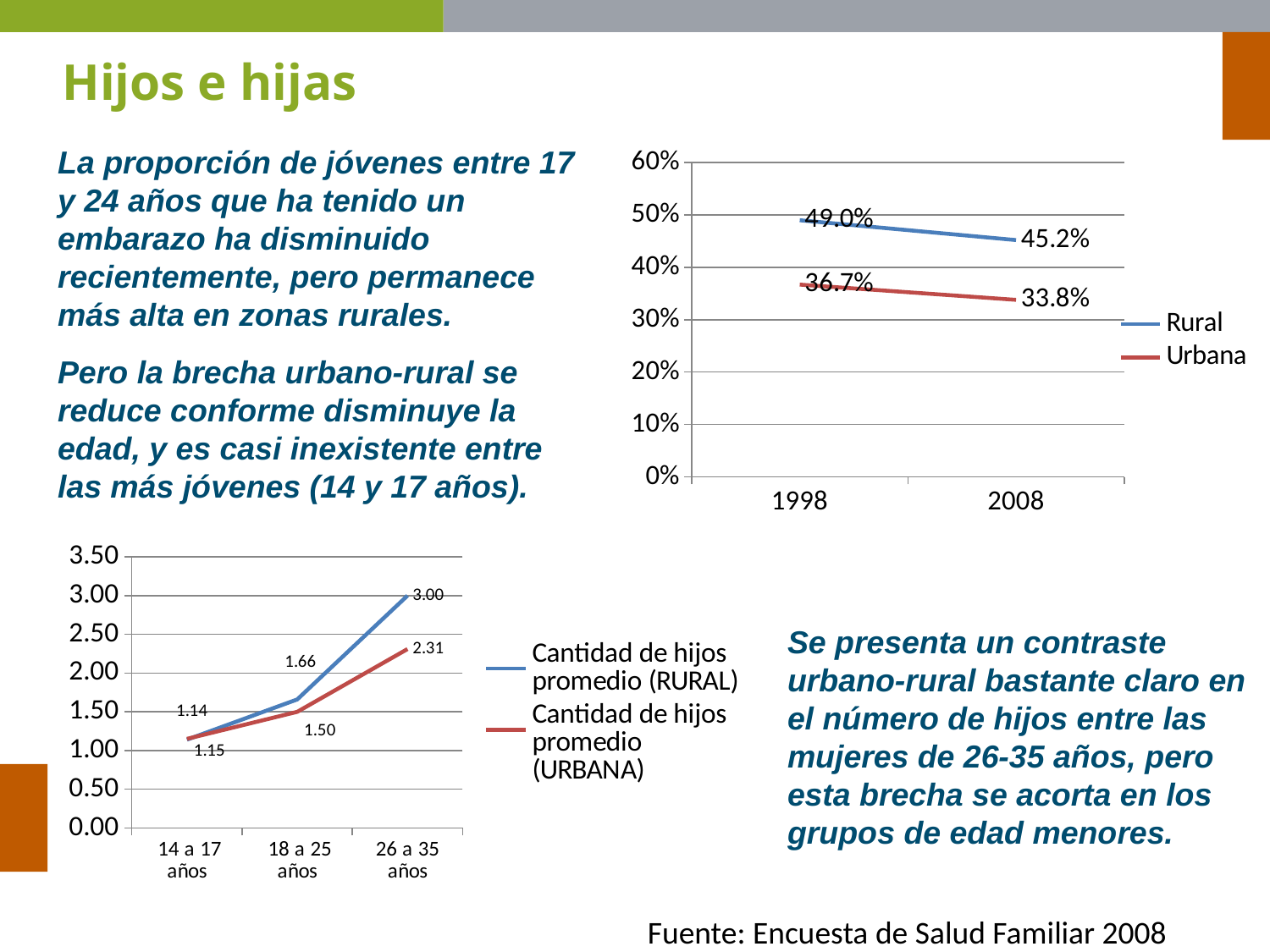
In the bottom-left chart, which age group has the highest value for Cantidad de hijos promedio (URBANA)? 26 a 35 años In the top-right chart, by how many percentage points did the Rural value fall from 1998 to 2008? 3.8 percentage points In the top-right chart, what is the Urbana value for 2008? 33.8% In the top-right chart, which series is higher in 2008, Rural or Urbana? Rural In the bottom-left chart, how many age groups are shown on the x axis? 3 In the bottom-left chart, what is the value of Cantidad de hijos promedio (RURAL) for 26 a 35 años? 3.00 In the top-right chart, how many series does the legend list? 2 In the top-right chart, what is the Rural value for 1998? 49.0% In the top-right chart, does the Urbana line rise or fall from 1998 to 2008? Fall In the bottom-left chart, what is the difference between the RURAL and URBANA values for 26 a 35 años? 0.69 In the bottom-left chart, what is the value of Cantidad de hijos promedio (URBANA) for 18 a 25 años? 1.50 What kind of chart is the bottom-left chart? Line chart